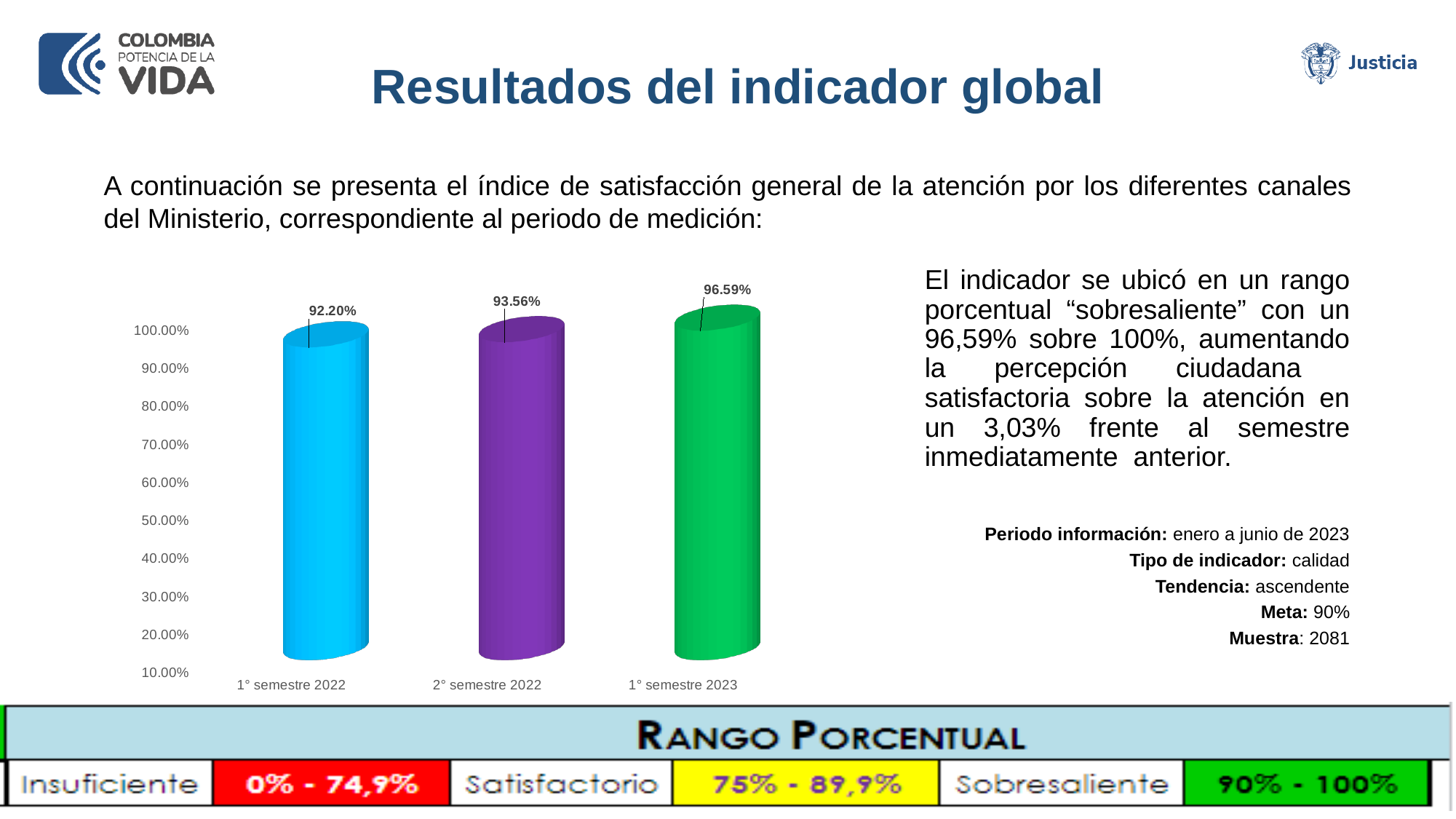
How many periods are shown on the x axis of the chart? 3 Do the values rise or fall from 1° semestre 2022 to 1° semestre 2023? rise Which period has the highest value? 1° semestre 2023 What is the value for 1° semestre 2023? 96.59% Which is larger, the value for 1° semestre 2023 or the value for 1° semestre 2022? 1° semestre 2023 What is the value for 2° semestre 2022? 93.56% Is the value for 1° semestre 2022 greater or less than 90.00%? greater What is the difference between the values for 2° semestre 2022 and 1° semestre 2022? 1.36% What kind of chart is shown on the slide? bar chart What is the difference between the values for 1° semestre 2023 and 2° semestre 2022? 3.03% What is the value for 1° semestre 2022? 92.20% Which period has the lowest value? 1° semestre 2022